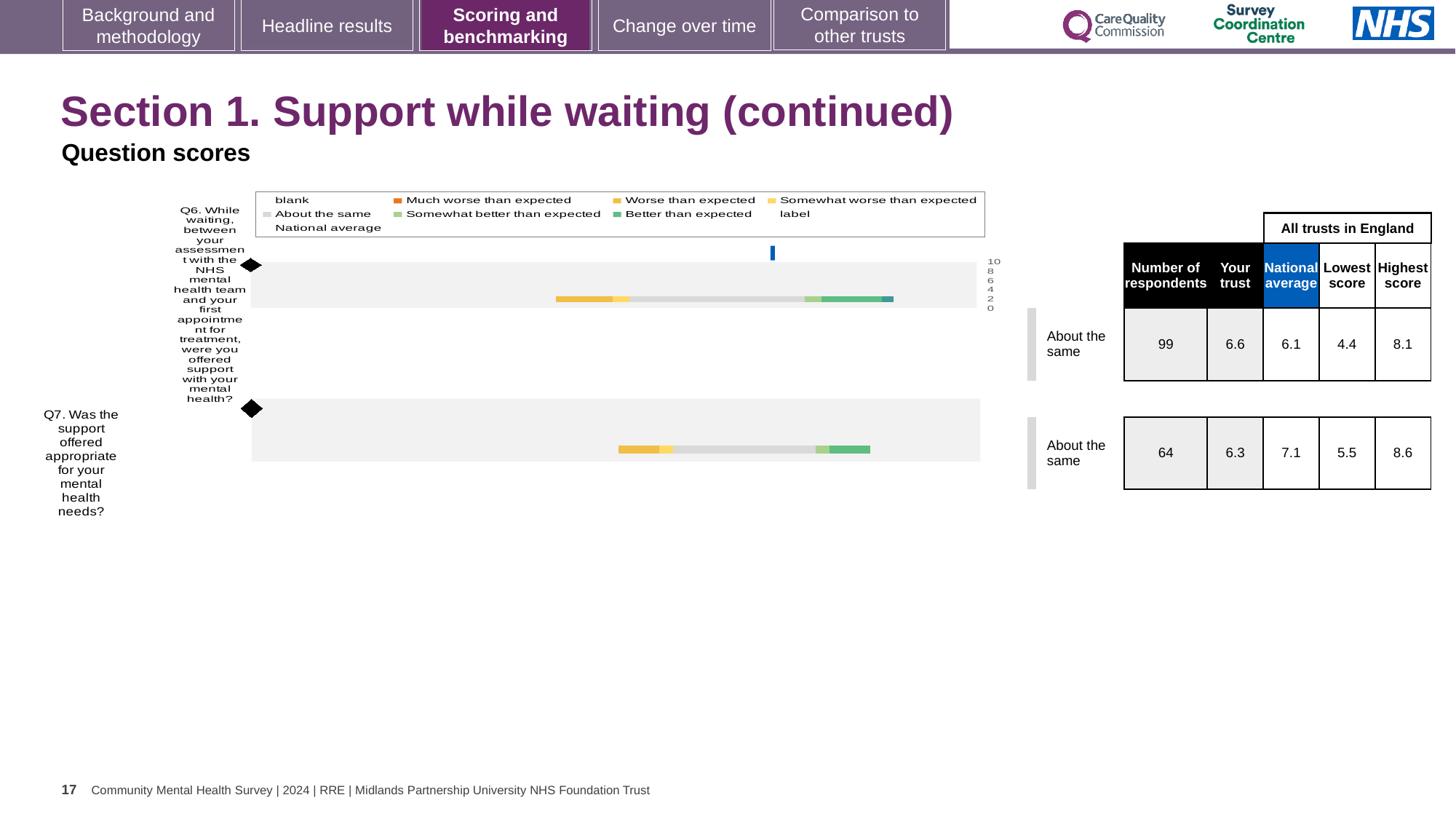
How many questions (bars) are plotted in the chart? 2 What is the 'Your trust' score for Q7? 6.3 For Q6, what is the difference between the highest score and the lowest score across all trusts in England? 3.7 How many respondents answered Q7? 64 What is the national average score for Q6? 6.1 For Q7, what is the difference between the national average and the 'Your trust' score? 0.8 What is the 'Your trust' score for Q6? 6.6 For Q6, which is larger: the 'Your trust' score or the national average? Your trust Which question had more respondents, Q6 or Q7? Q6 What benchmarking category is shown for both Q6 and Q7? About the same What kind of chart is shown on the slide? bar chart What is the national average score for Q7? 7.1